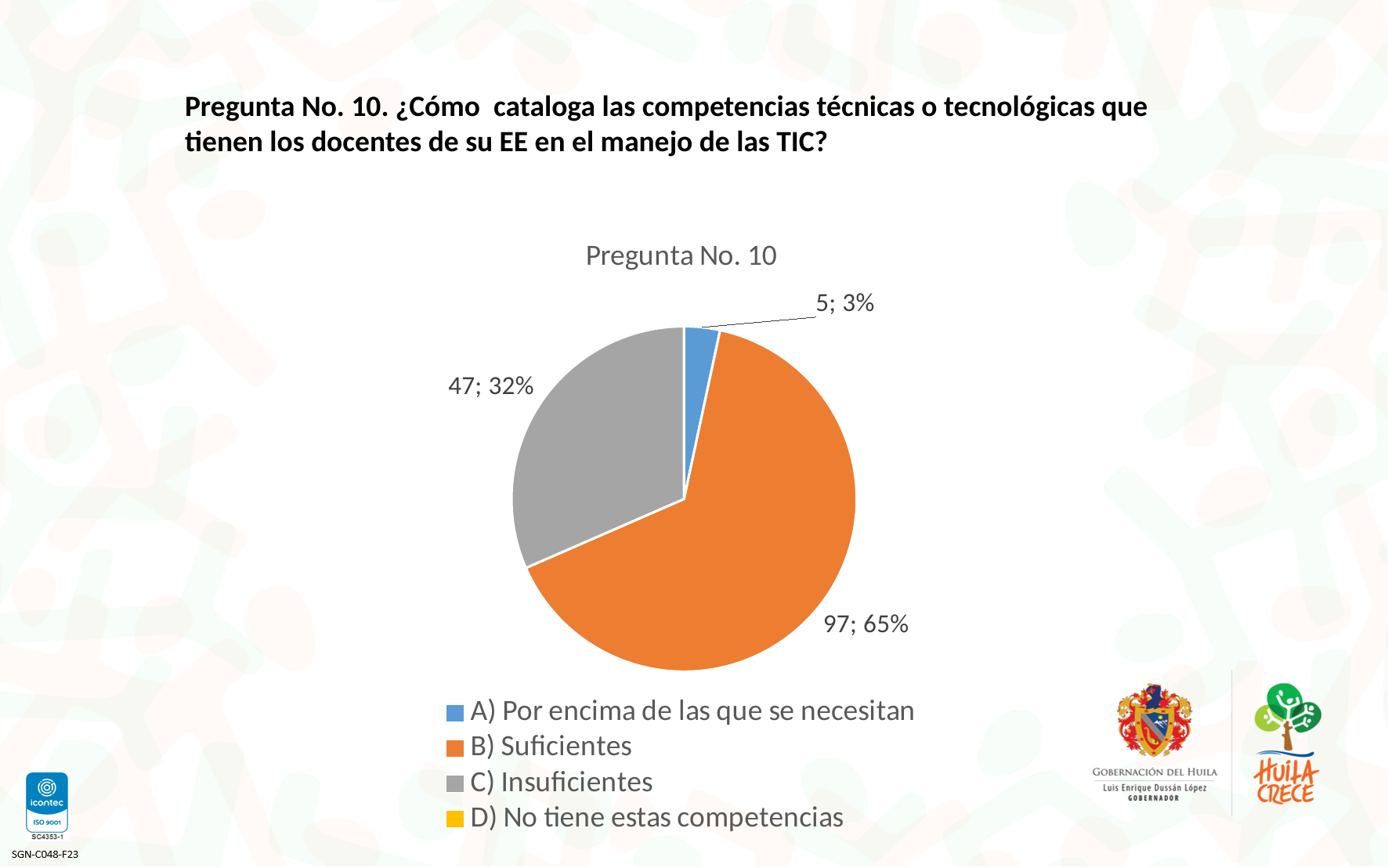
What share of the pie does C) Insuficientes represent? 32% What share of the pie does A) Por encima de las que se necesitan represent? 3% What kind of chart is shown on the slide? pie chart What is the difference in count between B) Suficientes and C) Insuficientes? 50 What is the count for A) Por encima de las que se necesitan? 5 What is the count for C) Insuficientes? 47 What is the title of the chart? Pregunta No. 10 Which legend entry is shown in orange? B) Suficientes What is the count for B) Suficientes? 97 How many entries does the chart legend list? 4 What share of the pie does B) Suficientes represent? 65% Which category has the largest slice? B) Suficientes